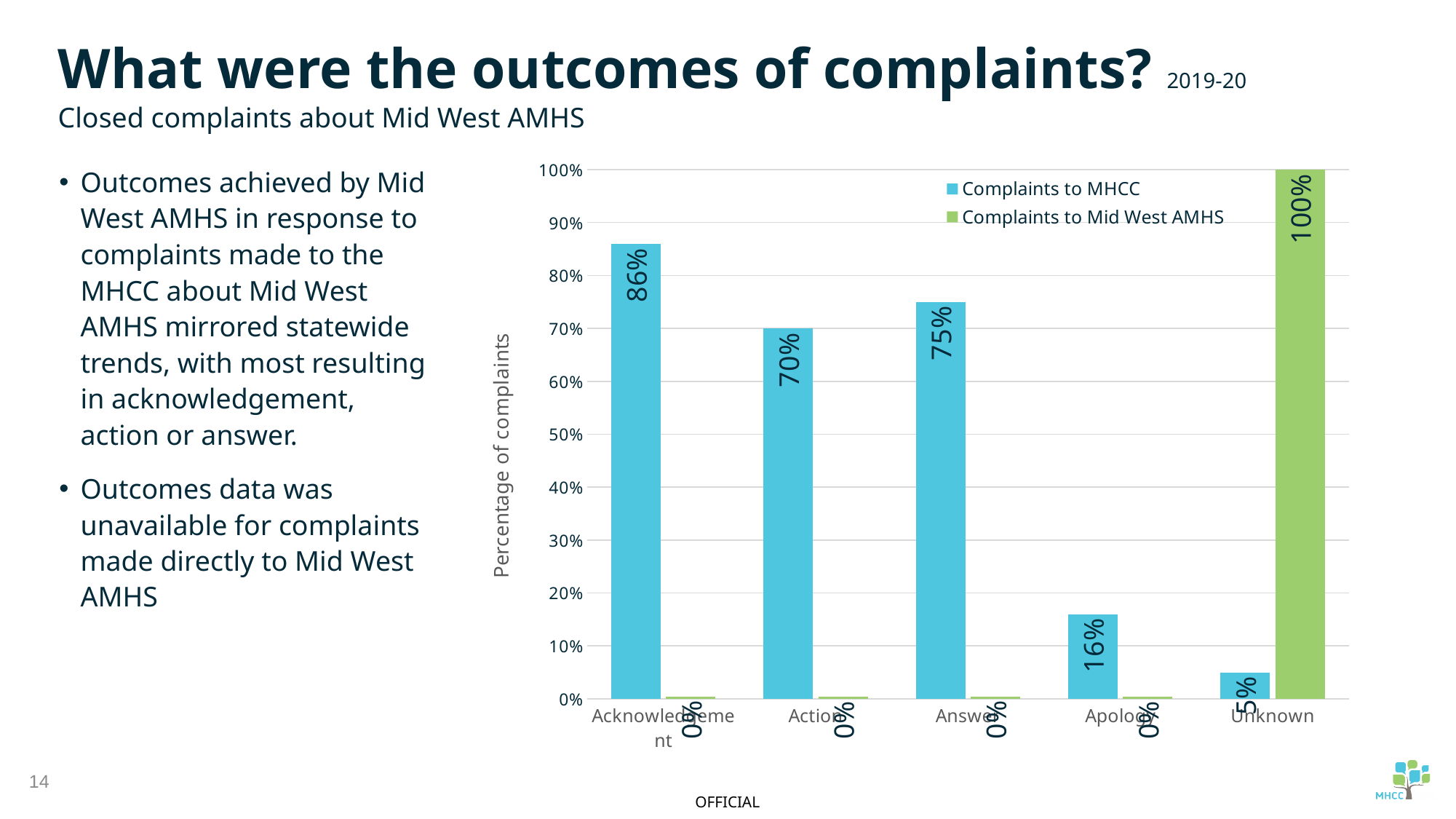
For Complaints to MHCC, which is larger: Action or Answer? Answer Which outcome category has the lowest value for Complaints to MHCC? Unknown How many series does the legend list? 2 How many outcome categories are shown on the x axis? 5 What percentage of complaints to MHCC resulted in Action? 70% What is the label of the vertical axis? Percentage of complaints What kind of chart is shown on the slide? Bar chart Which outcome category has the highest value for Complaints to MHCC? Acknowledgement What percentage of complaints to MHCC resulted in Apology? 16% What percentage of complaints to MHCC resulted in Acknowledgement? 86% What is the difference between the Complaints to MHCC values for Acknowledgement and Answer? 11% What percentage of complaints to Mid West AMHS have an Unknown outcome? 100%